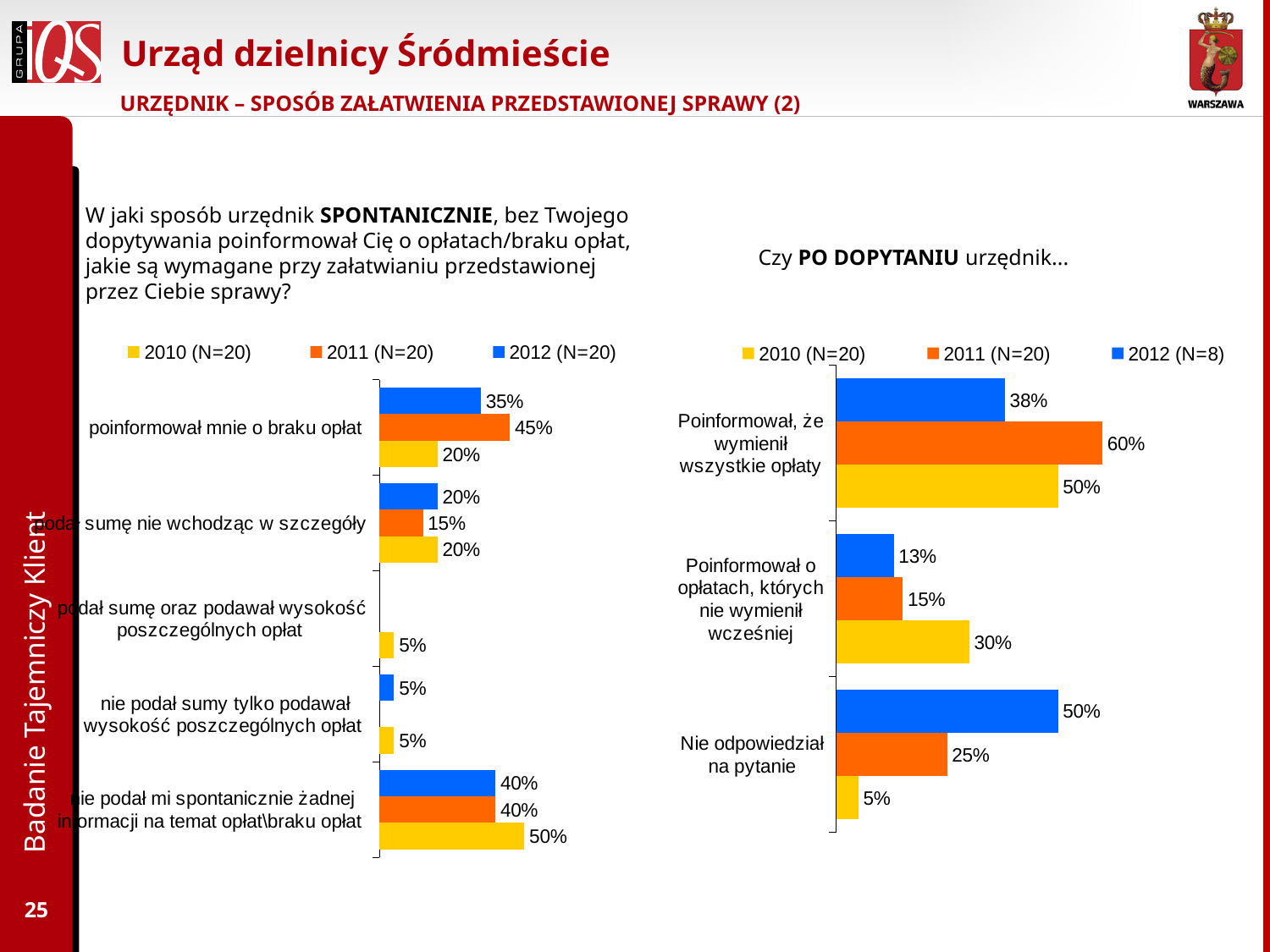
How many series does the legend of the right chart list? 3 In the left chart, what is the difference between the 2011 and 2010 values for "poinformował mnie o braku opłat"? 25 percentage points In the right chart, what is the 2012 value for "Nie odpowiedział na pytanie"? 50% In the left chart, what is the 2011 value for "poinformował mnie o braku opłat"? 45% What type of chart is the right chart? Bar chart In the right chart, what is the 2011 value for "Poinformował, że wymienił wszystkie opłaty"? 60% In the right chart, which category has the highest 2010 value? Poinformował, że wymienił wszystkie opłaty How many categories does the left chart show? 5 In the left chart, what is the 2010 value for "nie podał mi spontanicznie żadnej informacji na temat opłat\braku opłat"? 50% In the right chart, which is larger for "Poinformował o opłatach, których nie wymienił wcześniej": the 2010 value or the 2012 value? 2010 In the right chart's legend, what is the sample size (N) given for 2012? N=8 In the right chart, which category has the lowest 2010 value? Nie odpowiedział na pytanie